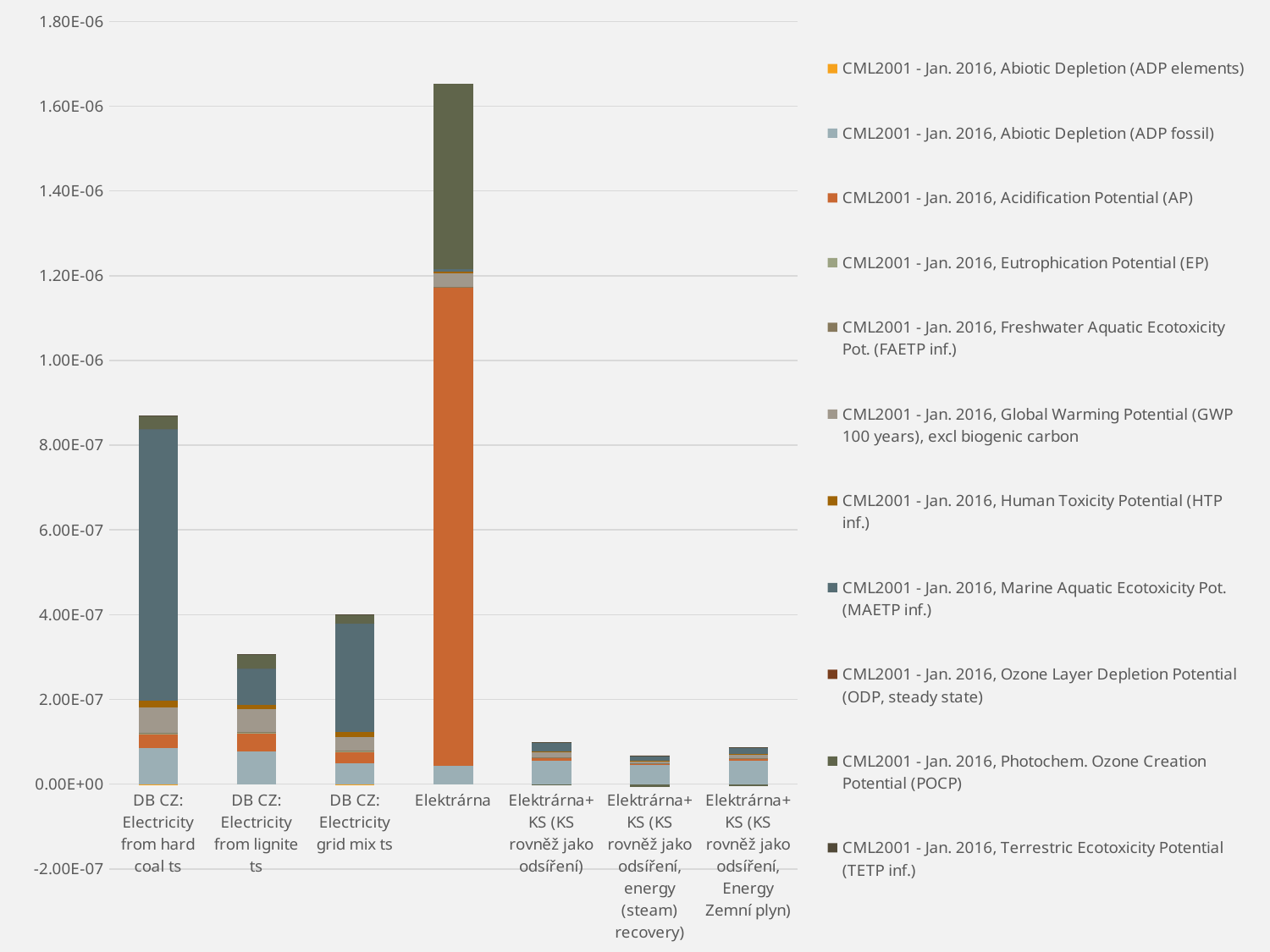
Which category has the tallest stacked bar? Elektrárna Which series makes up the largest part of the Elektrárna bar? CML2001 - Jan. 2016, Acidification Potential (AP) Which has the larger stacked bar, DB CZ: Electricity from hard coal ts or DB CZ: Electricity from lignite ts? DB CZ: Electricity from hard coal ts Is the total for DB CZ: Electricity grid mix ts greater or less than 6.00E-07? less What kind of chart is shown on the slide? Stacked bar chart Is the total for DB CZ: Electricity from hard coal ts greater or less than 8.00E-07? greater Which series makes up the largest part of the DB CZ: Electricity from hard coal ts bar? CML2001 - Jan. 2016, Marine Aquatic Ecotoxicity Pot. (MAETP inf.) Which category has the shortest stacked bar? Elektrárna+KS (KS rovněž jako odsíření, energy (steam) recovery) How many categories are plotted along the x axis? 7 How many series does the legend list? 11 Is the total for DB CZ: Electricity from lignite ts greater or less than 4.00E-07? less